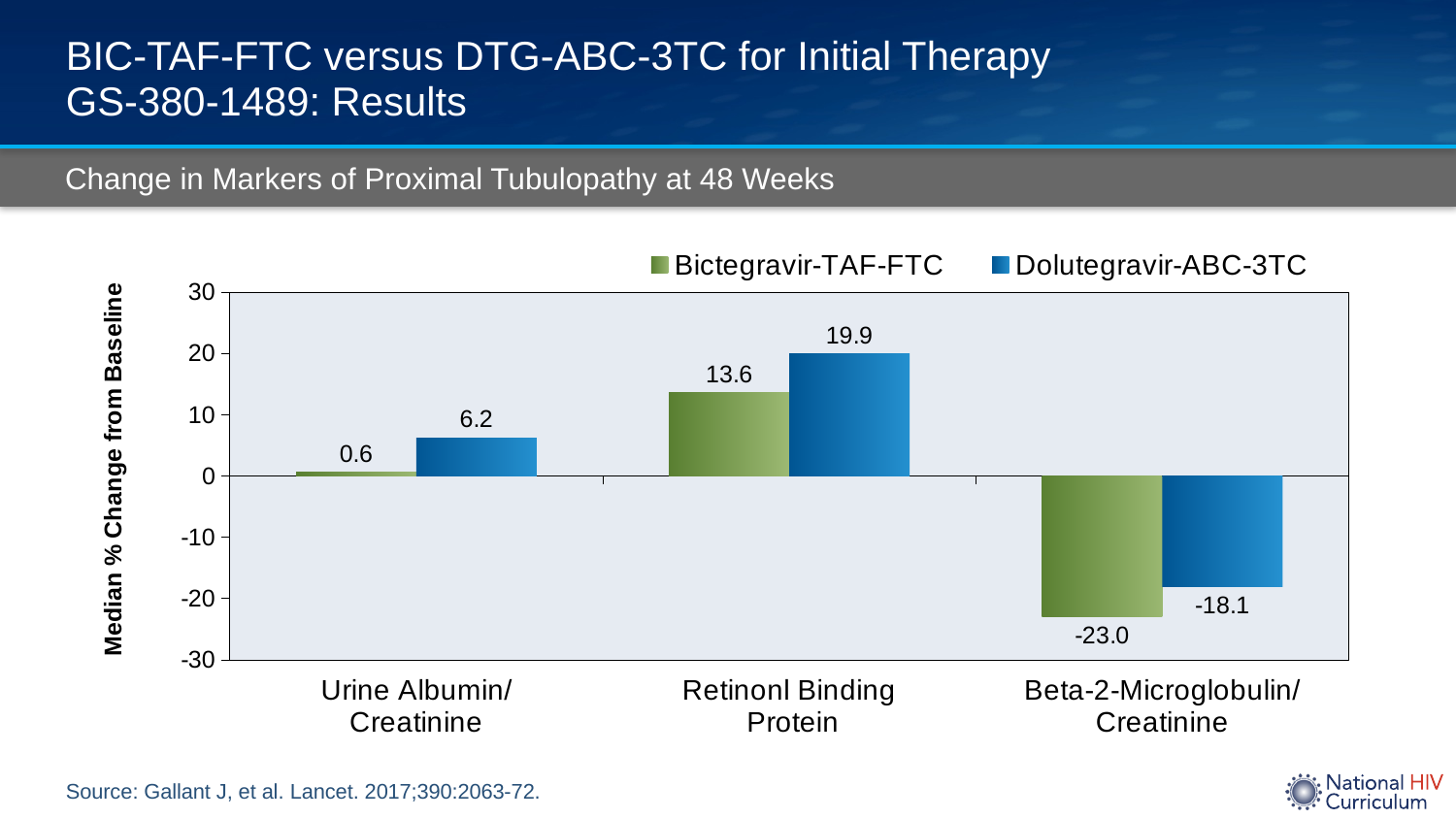
How many markers are shown on the x axis? 3 What is the median % change from baseline in Urine Albumin/Creatinine for Dolutegravir-ABC-3TC? 6.2 Is the Bictegravir-TAF-FTC value for Retinonl Binding Protein greater or less than 10? greater What is the median % change from baseline in Beta-2-Microglobulin/Creatinine for Bictegravir-TAF-FTC? -23.0 What kind of chart is shown on the slide? Bar chart Which marker shows the lowest value for Bictegravir-TAF-FTC? Beta-2-Microglobulin/Creatinine What is the difference between the Dolutegravir-ABC-3TC and Bictegravir-TAF-FTC values for Retinonl Binding Protein? 6.3 How many series does the legend list? 2 What is the median % change from baseline in Urine Albumin/Creatinine for Bictegravir-TAF-FTC? 0.6 For Urine Albumin/Creatinine, which regimen has the larger median % change from baseline? Dolutegravir-ABC-3TC What is the median % change from baseline in Retinonl Binding Protein for Dolutegravir-ABC-3TC? 19.9 Which marker shows the highest value for Dolutegravir-ABC-3TC? Retinonl Binding Protein